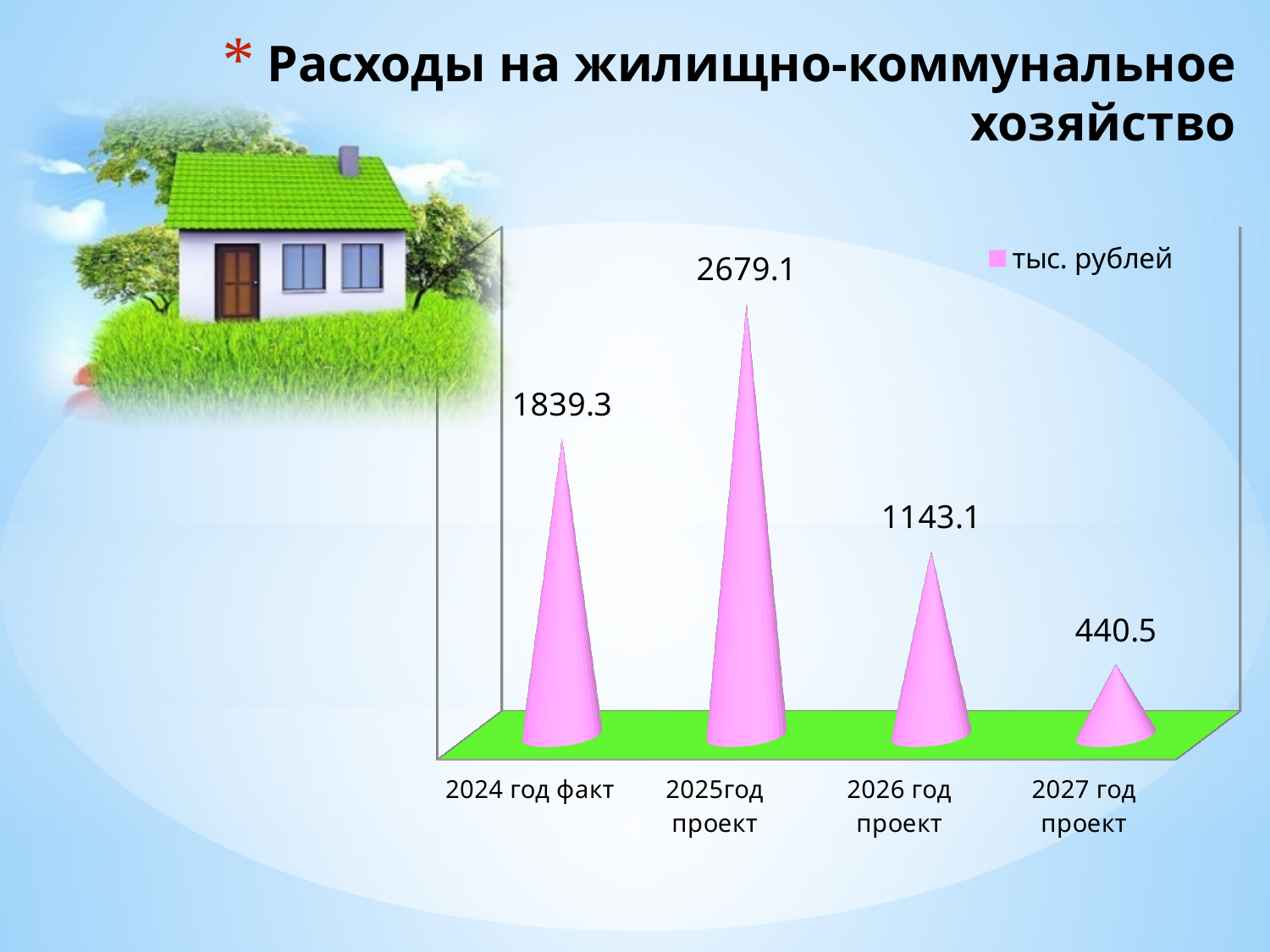
Which category has the highest value? 2025год проект What is the series name shown in the legend? тыс. рублей What is the value for 2024 год факт? 1839.3 Which is larger, the value for 2024 год факт or the value for 2026 год проект? 2024 год факт Which category has the lowest value? 2027 год проект How many categories are shown on the x axis? 4 What is the value for 2025год проект? 2679.1 What is the value for 2027 год проект? 440.5 What is the value for 2026 год проект? 1143.1 How many series does the legend list? 1 What is the difference between the values for 2026 год проект and 2027 год проект? 702.6 What is the difference between the values for 2025год проект and 2024 год факт? 839.8